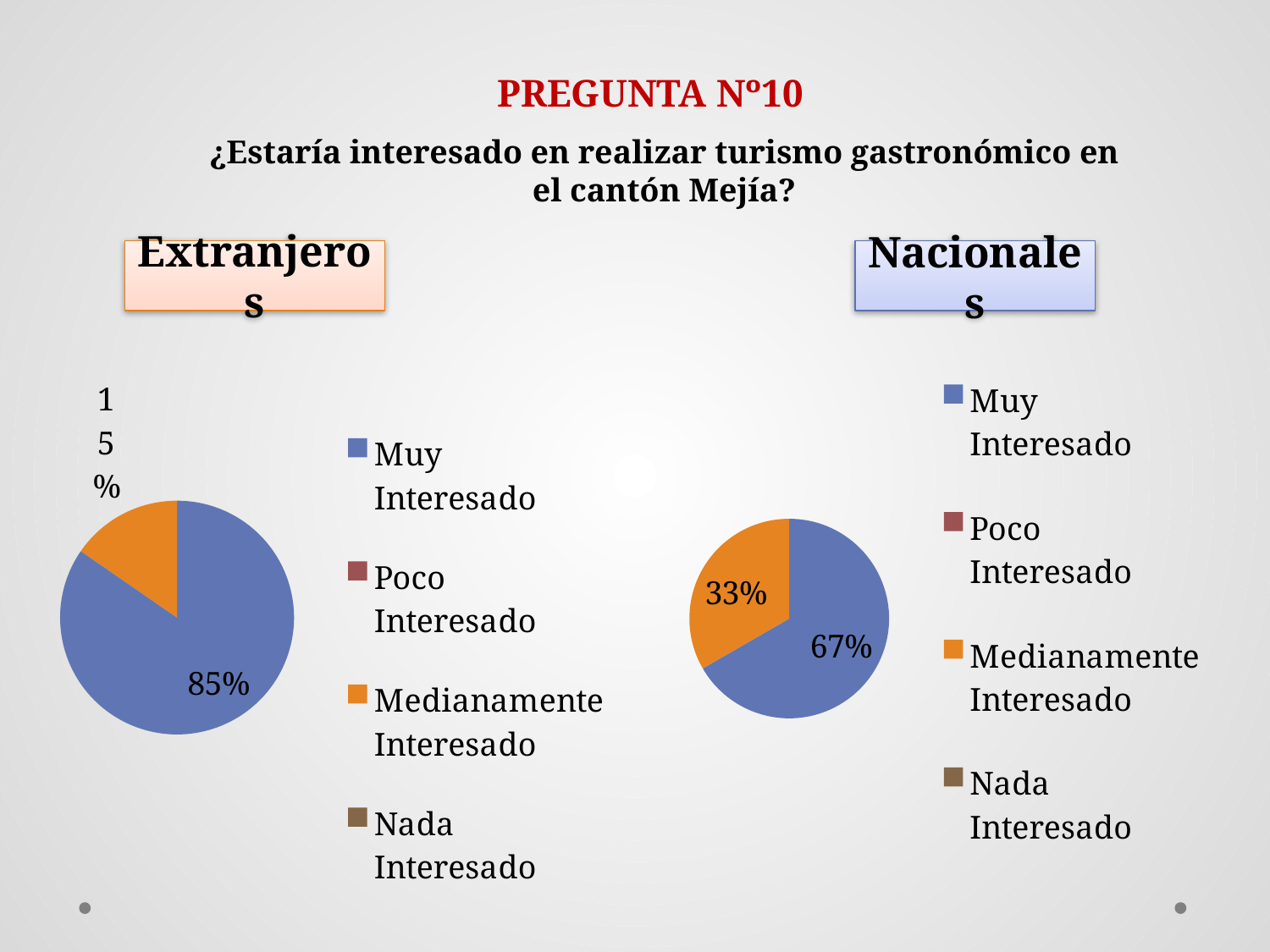
In the Nacionales pie chart, what colour is the Medianamente Interesado slice? Orange In the Extranjeros pie chart, what percentage is shown for Muy Interesado? 85% What type of chart is used for the Nacionales data? Pie chart In the Nacionales pie chart, what percentage is shown for Muy Interesado? 67% In the Nacionales pie chart, which category has the largest slice? Muy Interesado In the Nacionales pie chart, what is the difference between the Muy Interesado and Medianamente Interesado percentages? 34% In the Nacionales pie chart, what percentage is shown for Medianamente Interesado? 33% Which chart shows a higher percentage for Muy Interesado, Extranjeros or Nacionales? Extranjeros In the Extranjeros pie chart, what percentage is shown for Medianamente Interesado? 15% In the Extranjeros pie chart, what is the difference between the Muy Interesado and Medianamente Interesado percentages? 70% How many entries does the legend of the Extranjeros chart list? 4 In the Extranjeros pie chart, which of the two labelled slices is the smaller one? Medianamente Interesado